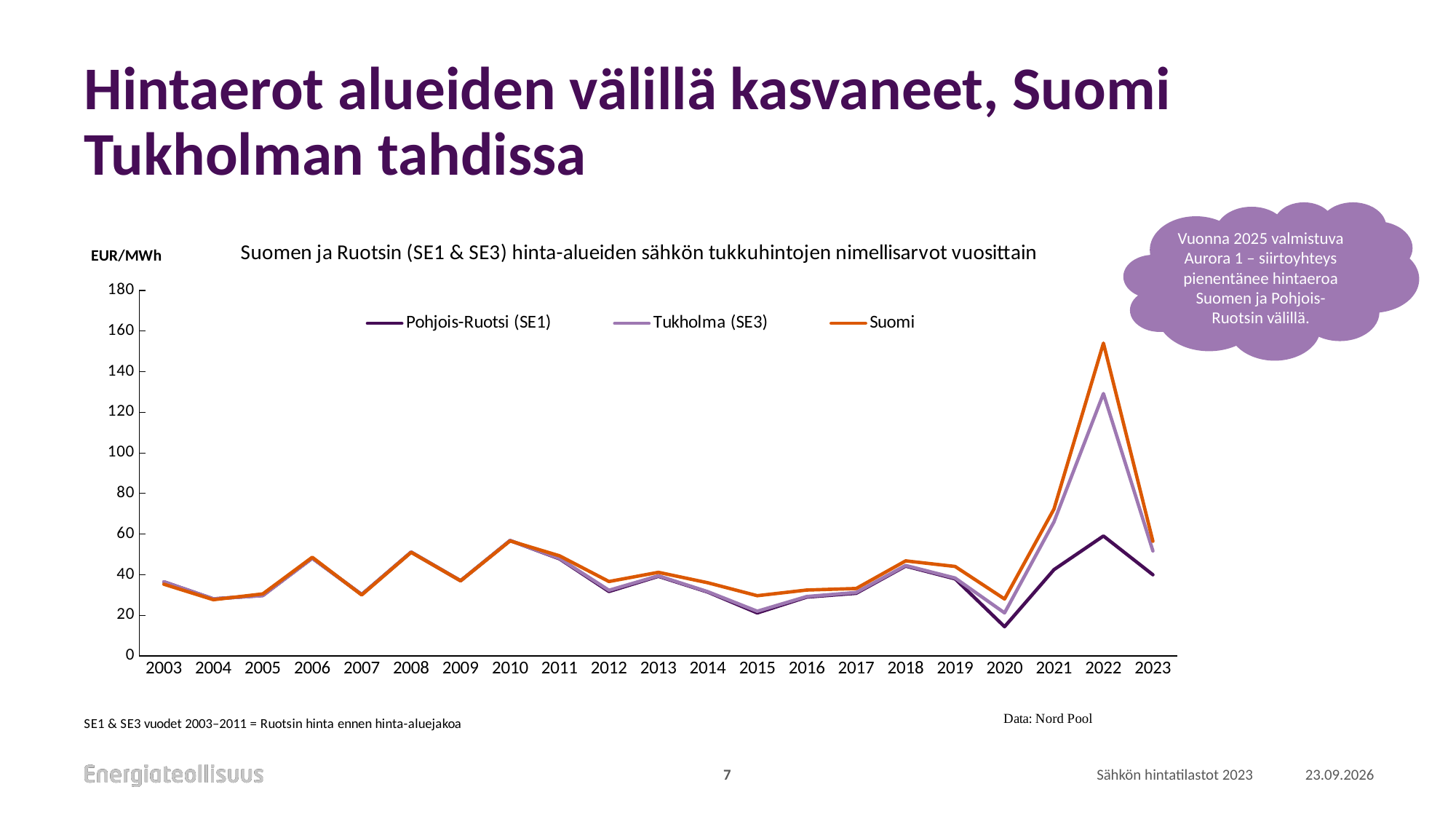
In which year does the Pohjois-Ruotsi (SE1) series reach its lowest value? 2020 Is the value for Pohjois-Ruotsi (SE1) in 2020 greater or less than 20? less Which series has the higher value in 2022, Suomi or Pohjois-Ruotsi (SE1)? Suomi What unit is shown on the y axis of the chart? EUR/MWh Do the values for Suomi rise or fall from 2020 to 2022? rise Is the value for Tukholma (SE3) in 2022 greater or less than 120? greater How many series does the legend list? 3 Which series has the higher value in 2023, Tukholma (SE3) or Pohjois-Ruotsi (SE1)? Tukholma (SE3) What kind of chart is shown on the slide? line chart Is the value for Suomi in 2022 greater or less than 140? greater In which year does the Suomi series reach its highest value? 2022 How many years are shown on the x axis? 21